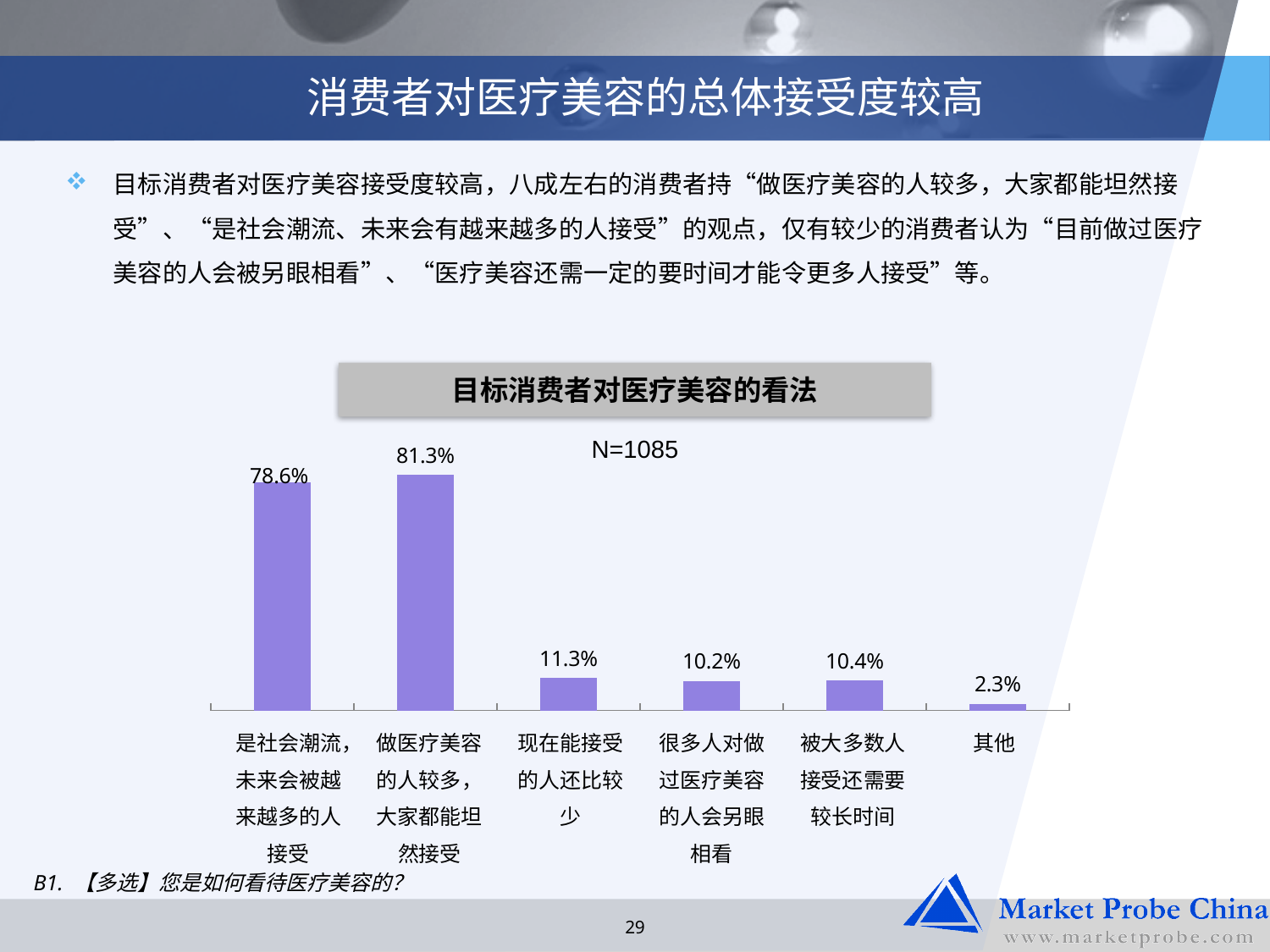
What is the sample size (N) shown on the chart? N=1085 How many categories are shown in the chart? 6 Which category has the lowest value? 其他 Which category has the highest value? 做医疗美容的人较多，大家都能坦然接受 What is the value for 做医疗美容的人较多，大家都能坦然接受? 81.3% Which is larger: the value for 现在能接受的人还比较少 or the value for 很多人对做过医疗美容的人会另眼相看? 现在能接受的人还比较少 What is the title of the chart? 目标消费者对医疗美容的看法 What is the value for 被大多数人接受还需要较长时间? 10.4% What is the value for 是社会潮流，未来会被越来越多的人接受? 78.6% What is the value for 其他? 2.3% What is the difference between the values for 做医疗美容的人较多，大家都能坦然接受 and 是社会潮流，未来会被越来越多的人接受? 2.7% What kind of chart is this? bar chart